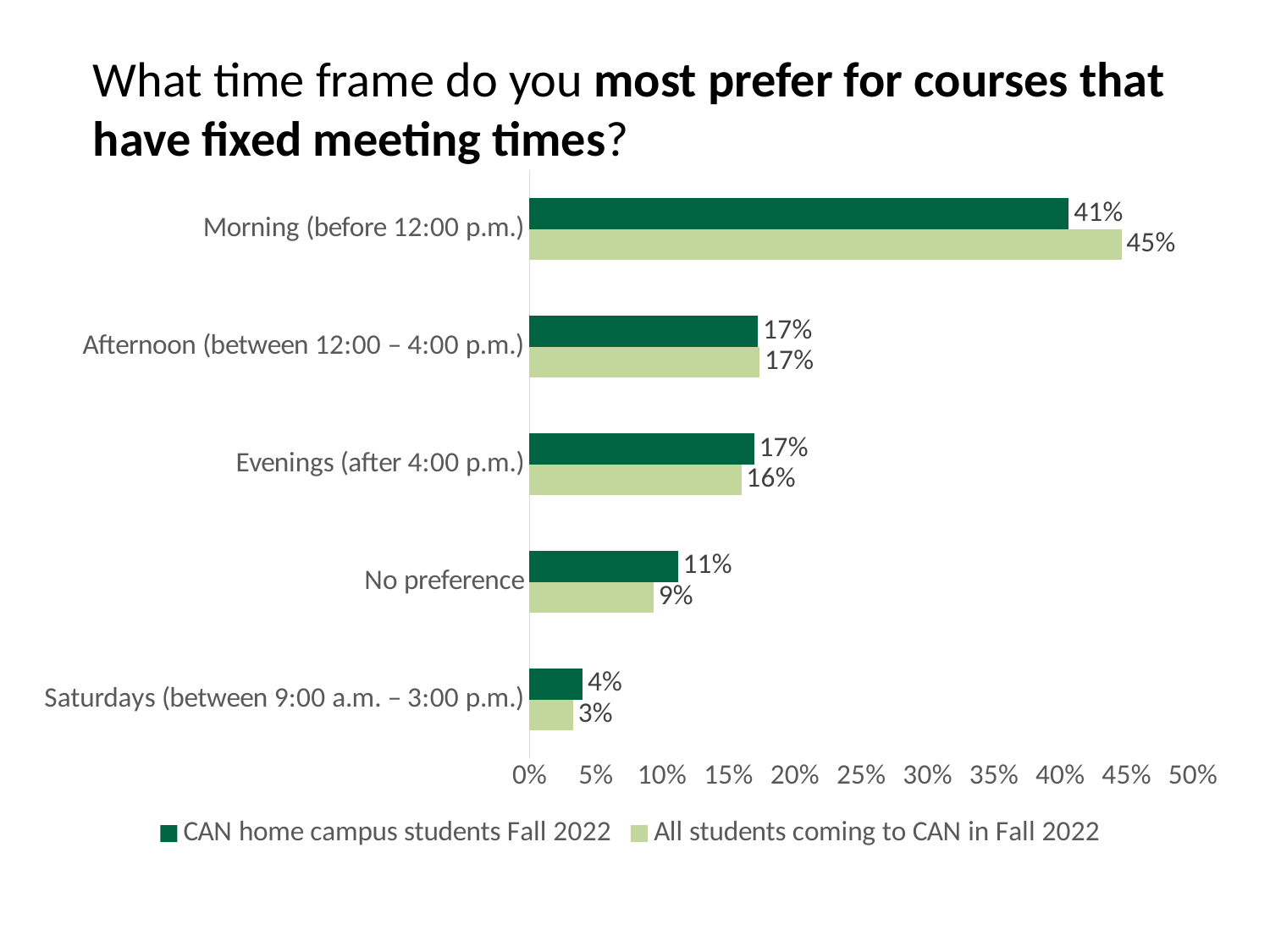
What is the difference between the All students coming to CAN in Fall 2022 value and the CAN home campus students Fall 2022 value for Morning (before 12:00 p.m.)? 4% For No preference, which series has the larger value: CAN home campus students Fall 2022 or All students coming to CAN in Fall 2022? CAN home campus students Fall 2022 How many series does the legend list? 2 What is the value for Saturdays (between 9:00 a.m. – 3:00 p.m.) among CAN home campus students Fall 2022? 4% How many time frame categories are shown on the chart? 5 Which time frame has the highest value for All students coming to CAN in Fall 2022? Morning (before 12:00 p.m.) Which time frame has the lowest value for CAN home campus students Fall 2022? Saturdays (between 9:00 a.m. – 3:00 p.m.) What percentage of All students coming to CAN in Fall 2022 most prefer Morning (before 12:00 p.m.)? 45% What kind of chart is shown on the slide? Bar chart What is the value for Evenings (after 4:00 p.m.) among All students coming to CAN in Fall 2022? 16% What is the value for No preference among All students coming to CAN in Fall 2022? 9% What percentage of CAN home campus students Fall 2022 most prefer Morning (before 12:00 p.m.)? 41%